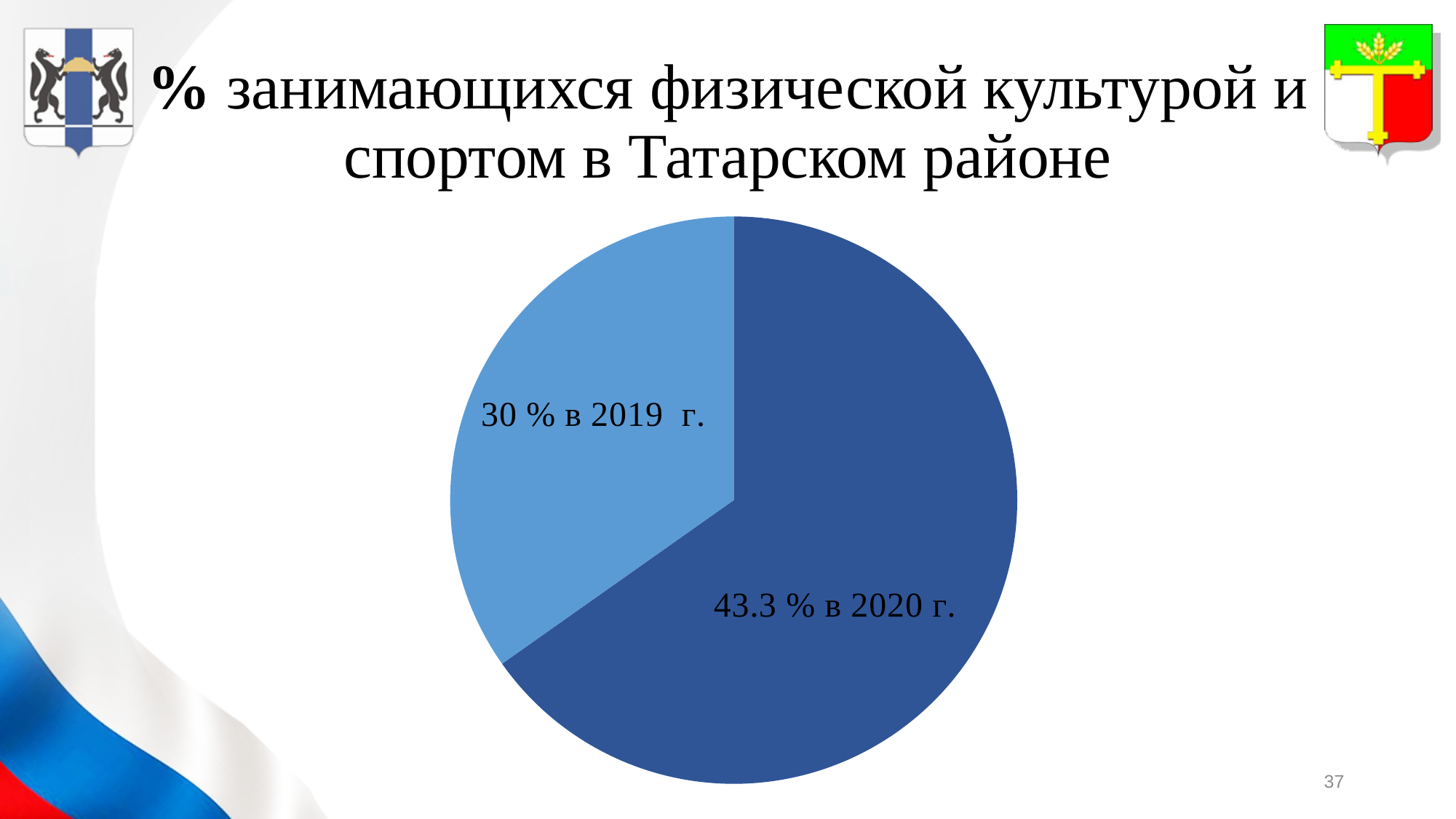
How many slices does the pie chart have? 2 Which year has the higher value on the pie chart? 2020 What value is shown for 2019 on the pie chart? 30 % Is the value for 2020 larger or smaller than the value for 2019? larger What is the title of the chart on the slide? % занимающихся физической культурой и спортом в Татарском районе Which slice is drawn in the darker blue colour, 2019 or 2020? 2020 By how many percentage points does the 2020 value exceed the 2019 value? 13.3 Which year has the lower value on the pie chart? 2019 What value is shown for 2020 on the pie chart? 43.3 % Did the share of people engaged in physical culture and sport rise or fall from 2019 to 2020? rise What kind of chart is shown on the slide? pie chart